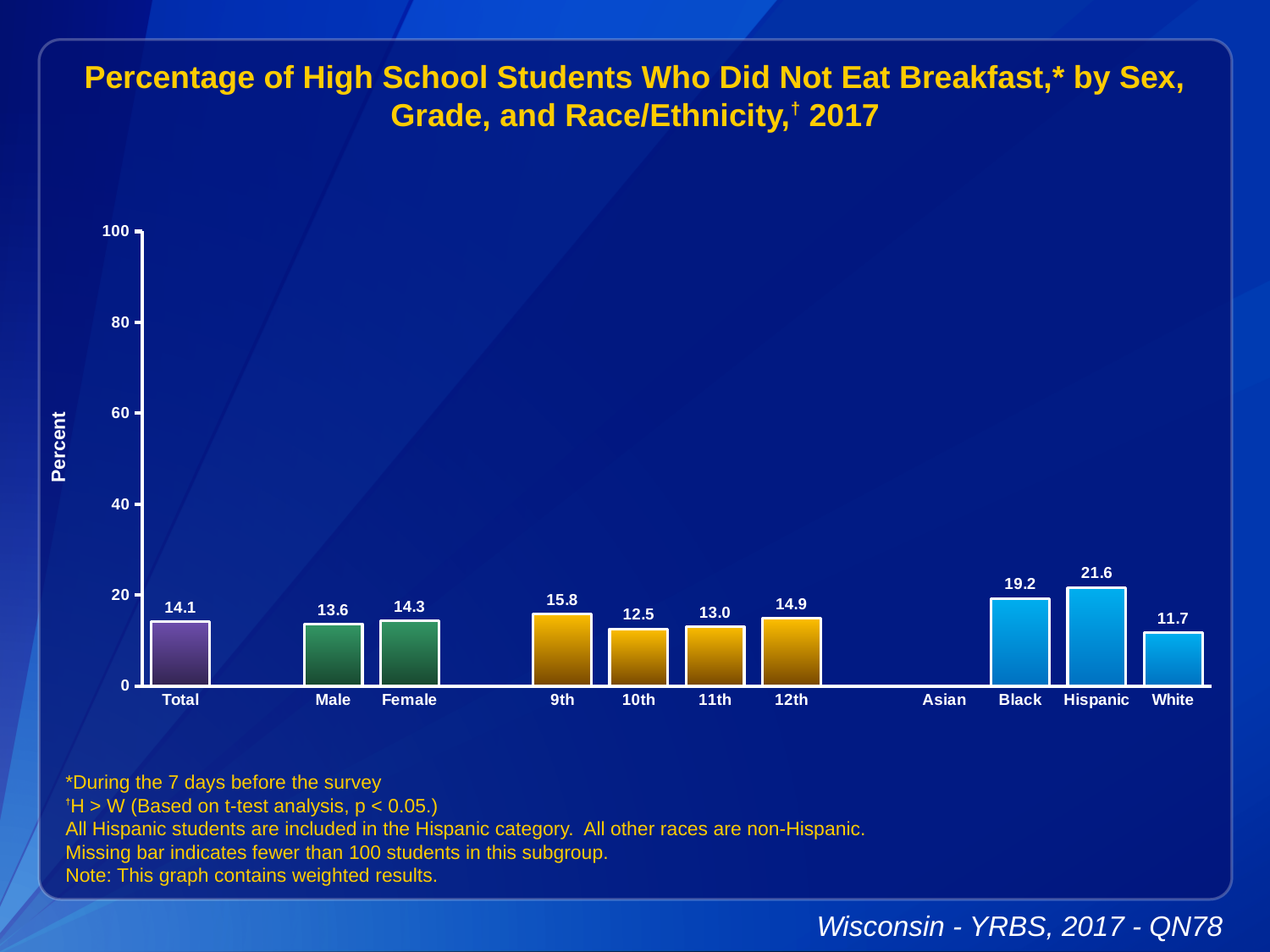
Which category has no bar shown? Asian What is the value for Total? 14.1 What is the value for 10th grade? 12.5 Which category with a plotted bar has the lowest value? White What percentage of Hispanic students did not eat breakfast? 21.6 What is the difference between the Female and Male values? 0.7 Which is larger, the value for 9th grade or 12th grade? 9th Which category has the highest value? Hispanic How many categories have a plotted bar? 10 Is the value for Hispanic greater or less than 20? greater What kind of chart is shown? bar chart What is the difference between the Black and White values? 7.5